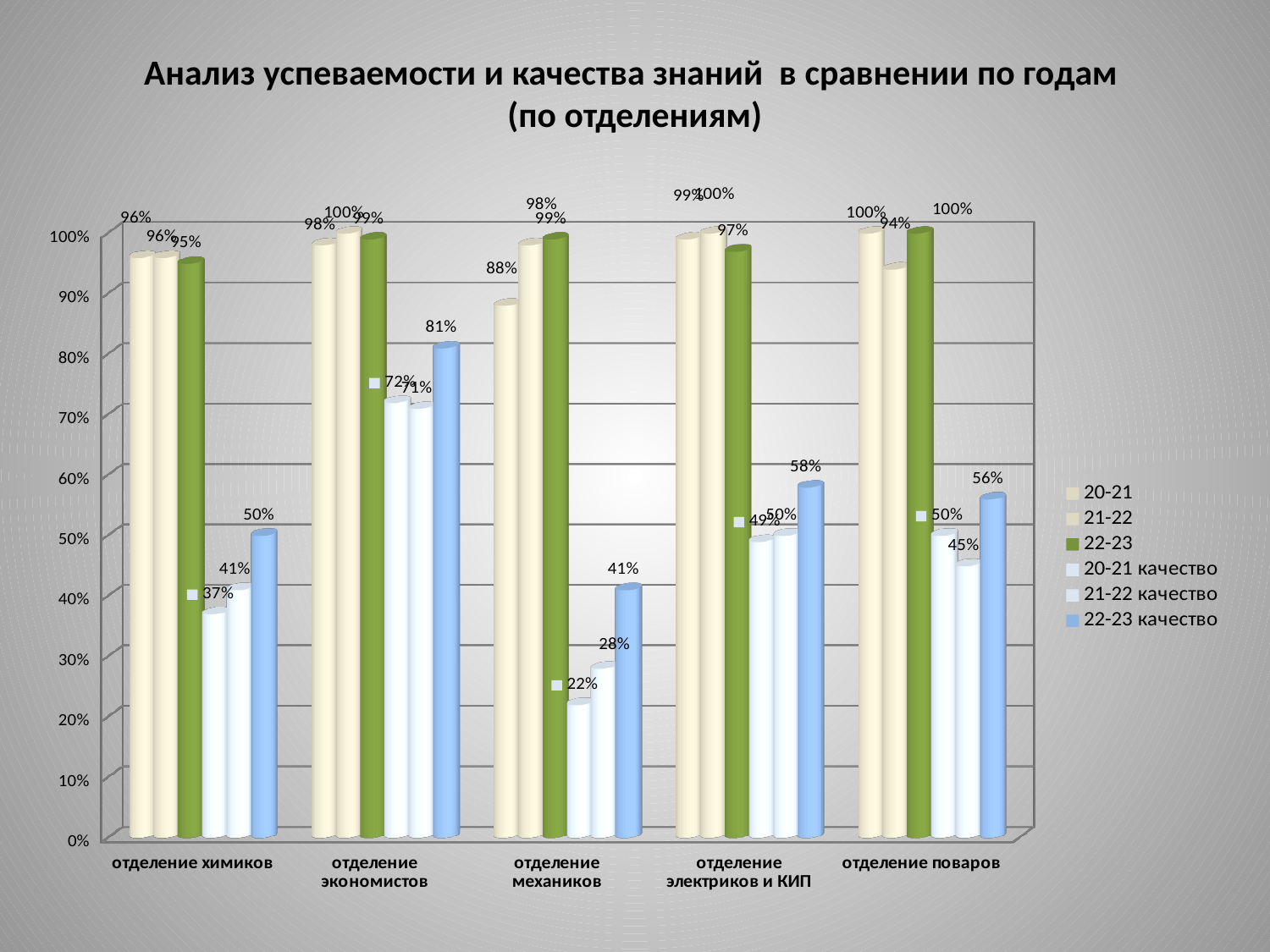
How many series does the legend list? 6 What is the value of the 21-22 series for отделение поваров? 94% Which category has the lowest value in the 20-21 качество series? отделение механиков Which category has the highest value in the 22-23 качество series? отделение экономистов What kind of chart is shown on the slide? bar chart Do the качество values for отделение механиков rise or fall from 20-21 to 22-23? rise How many categories (departments) are shown on the x axis? 5 What is the value of the 20-21 series for отделение механиков? 88% What is the value of the 22-23 качество series for отделение экономистов? 81% Which is larger for отделение химиков: the 21-22 качество value or the 22-23 качество value? 22-23 качество What is the title of the chart? Анализ успеваемости и качества знаний в сравнении по годам (по отделениям) What is the difference between the 22-23 качество and 20-21 качество values for отделение механиков? 19%